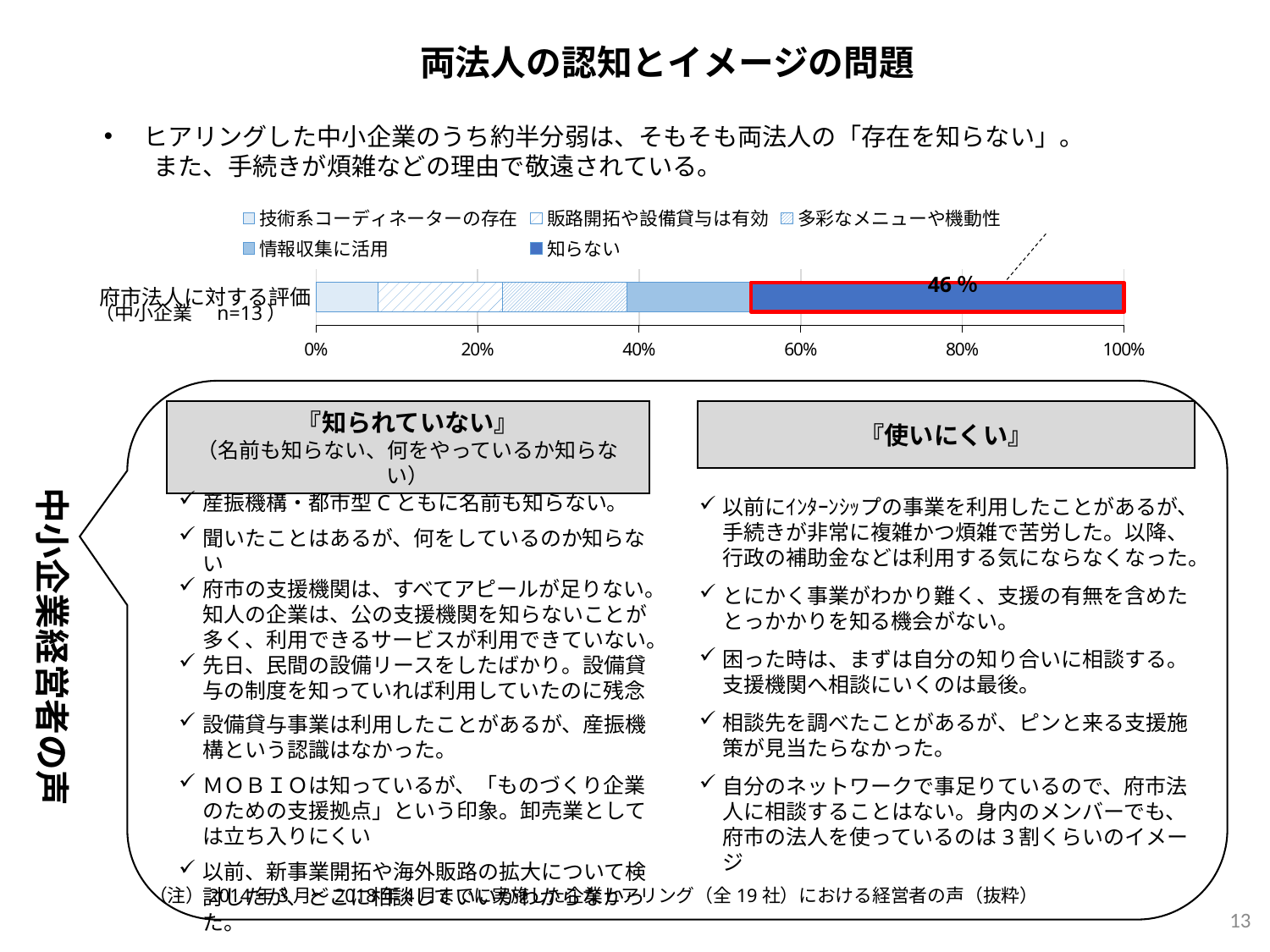
Is the value for 「知らない」 greater or less than 40%? greater What value is labelled on the 「知らない」 segment of the bar? 46 % What kind of chart is shown on the slide? bar chart Which segment is larger, 「知らない」 or 「情報収集に活用」? 知らない How many categories (bars) are plotted in the chart? 1 Which series has the smallest segment in the stacked bar? 技術系コーディネーターの存在 What is the sample size (n) given in the category label of the chart? n=13 Is the value for 「技術系コーディネーターの存在」 greater or less than 20%? less Which series has the largest segment in the stacked bar? 知らない What is the maximum value shown on the horizontal axis? 100% How many series does the chart legend list? 5